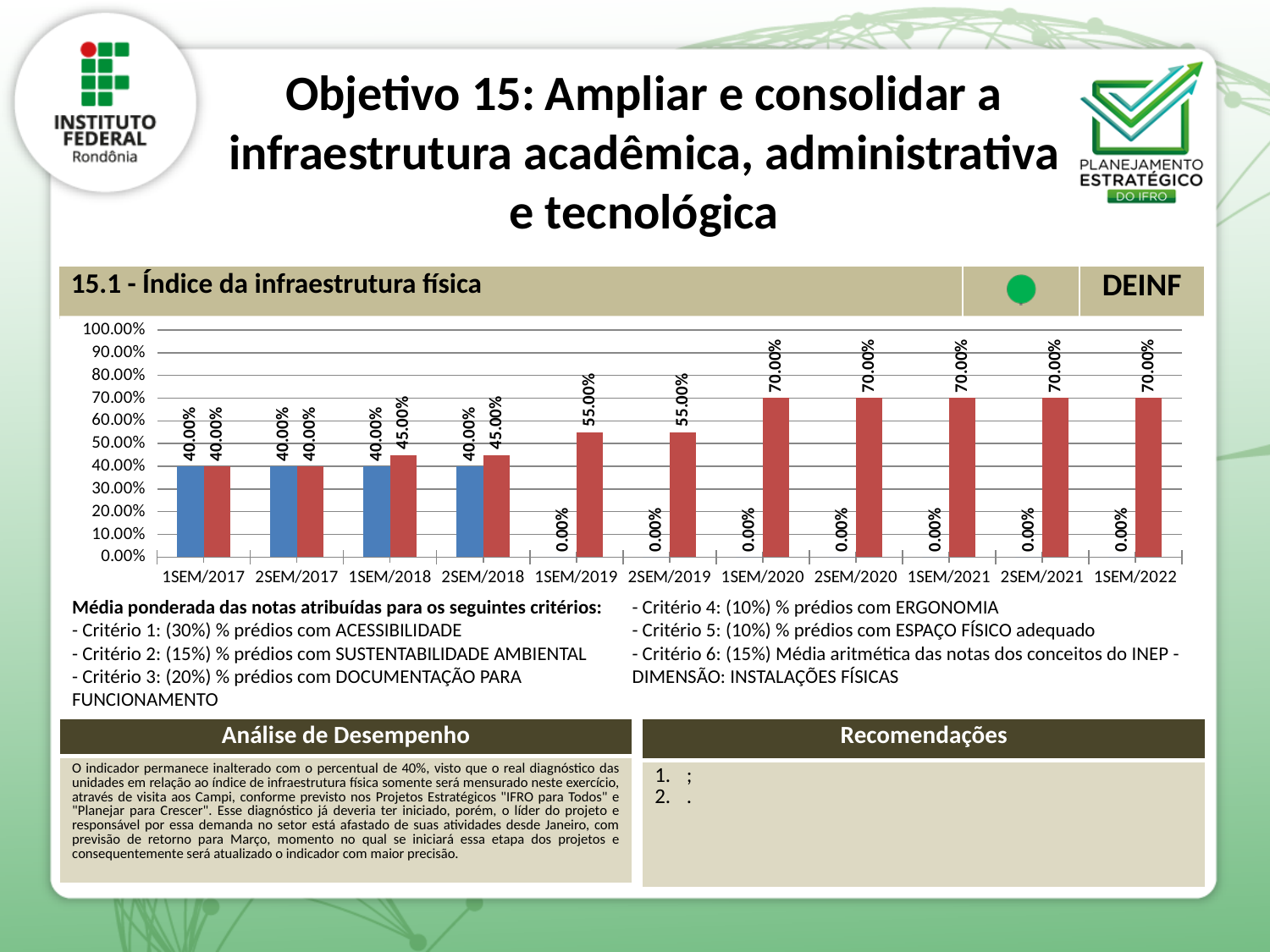
What type of chart is shown on the slide? bar chart What is the difference between the red bar for 1SEM/2020 and the red bar for 2SEM/2019? 15.00% What is the title of the indicator shown above the chart? 15.1 - Índice da infraestrutura física Do the red bars rise or fall from 1SEM/2017 to 1SEM/2022? rise For 1SEM/2018, which is larger: the blue bar or the red bar? the red bar What is the value of the red bar for 1SEM/2019? 55.00% What is the value of the blue bar for 1SEM/2021? 0.00% How many semester categories are shown on the x axis of the chart? 11 What is the highest value reached by the red bars in the chart? 70.00% What is the lowest value shown by the red bars in the chart? 40.00% What is the value of the blue bar for 2SEM/2018? 40.00% What is the difference between the red bar and the blue bar for 2SEM/2018? 5.00%